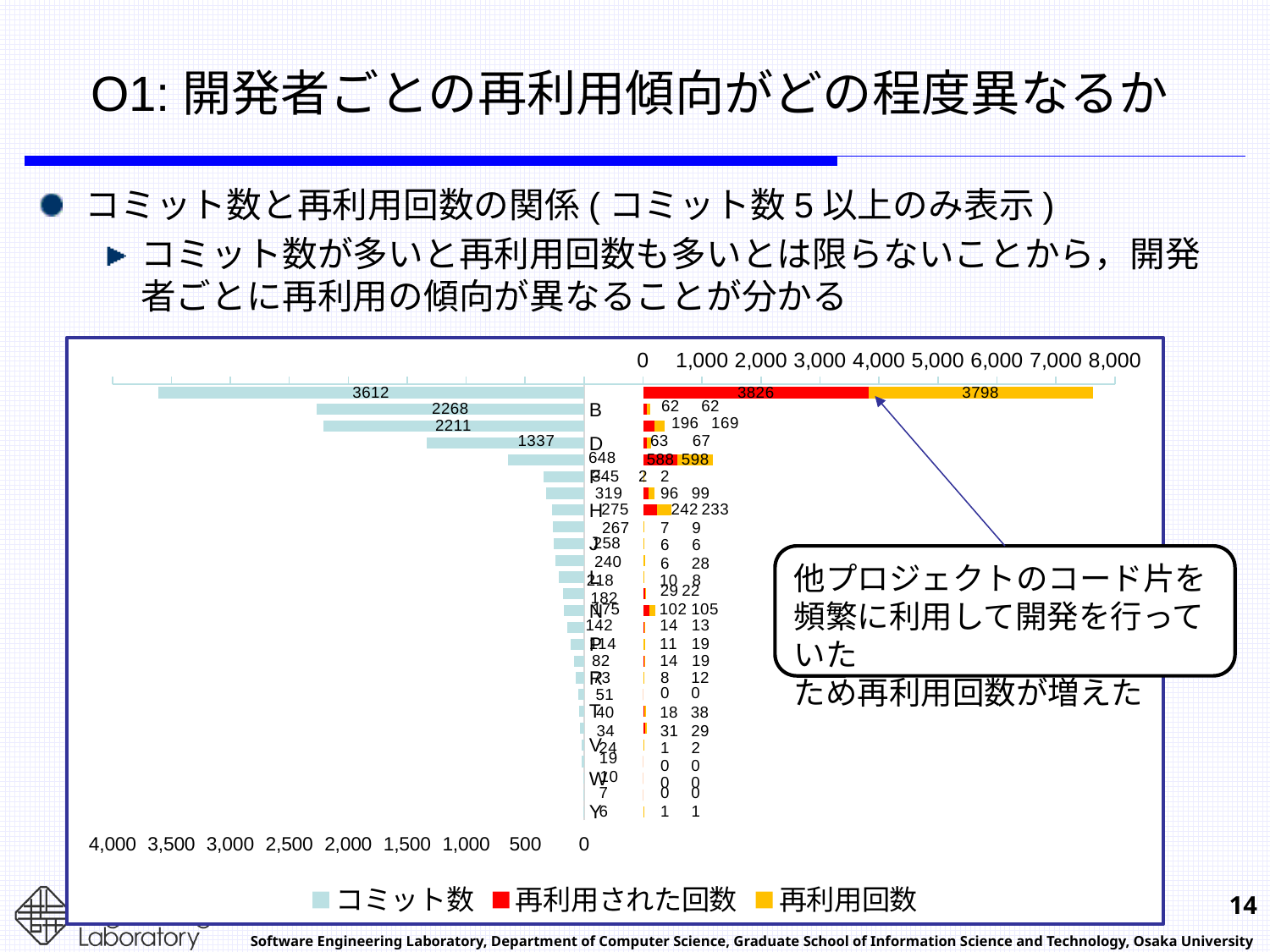
Which developer has a larger コミット数, B or D? B What are the three series named in the legend? コミット数, 再利用された回数, 再利用回数 For the developer with the most commits, what is the difference between 再利用された回数 (3826) and 再利用回数 (3798)? 28 What is the コミット数 value for developer B? 2268 What is the largest 再利用された回数 value shown in the chart? 3826 What kind of chart is shown on the slide? bar chart How many series does the chart legend list? 3 What is the largest コミット数 value shown in the chart? 3612 What is the 再利用回数 value for developer N? 105 Do the コミット数 values rise or fall going down the list of developers from top to bottom? fall What is the 再利用された回数 value for developer H? 242 What is the コミット数 value for developer D? 1337